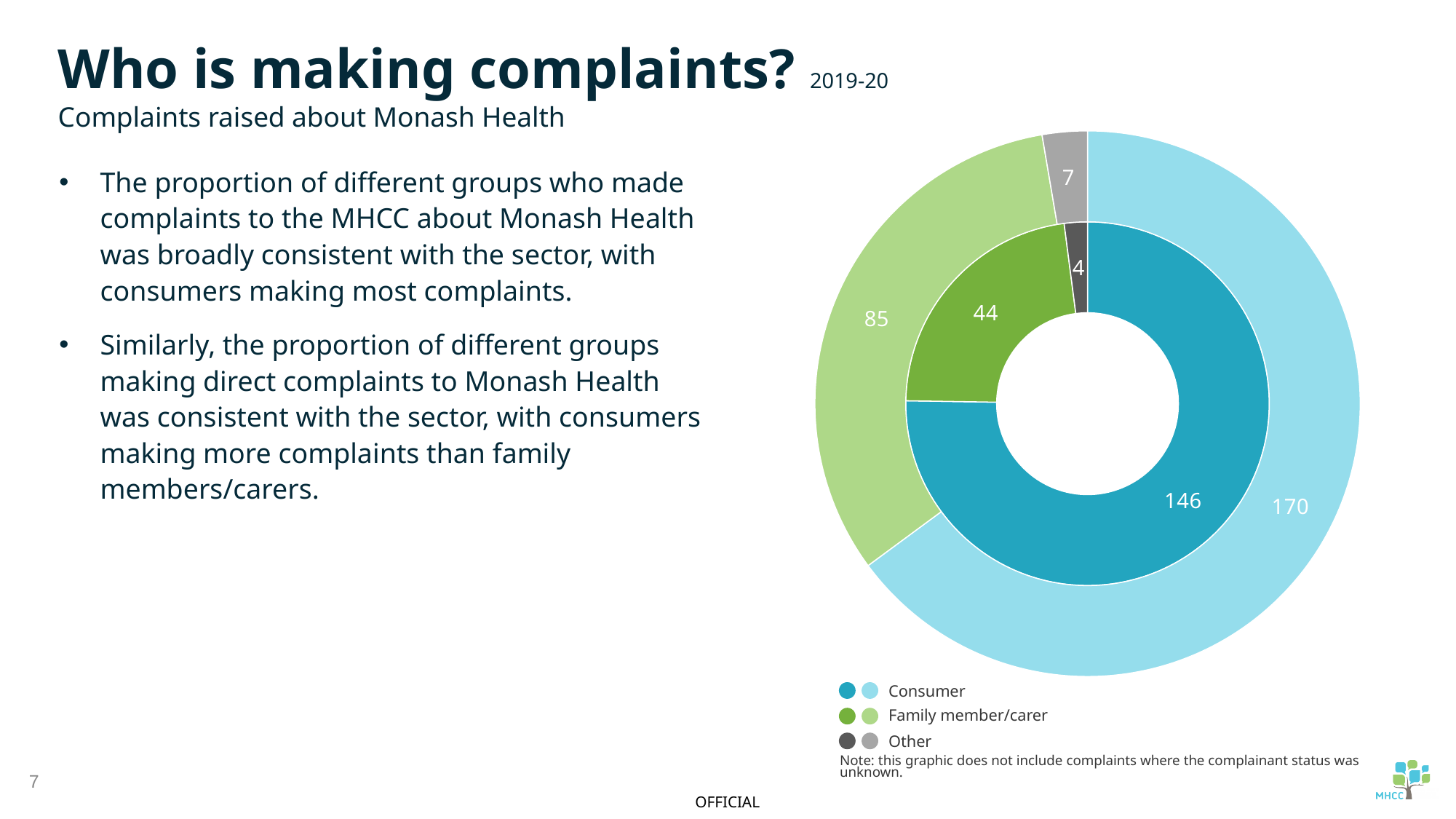
What kind of chart is shown on the slide? doughnut chart How many categories does the legend of the doughnut chart list? 3 What is the value for Consumer in the inner ring of the doughnut chart? 146 What is the difference between the Consumer and Family member/carer values in the outer ring? 85 Which category has the largest value in the outer ring of the doughnut chart? Consumer What is the total of the values in the inner ring of the doughnut chart? 194 What is the value for Other in the inner ring of the doughnut chart? 4 Which category has the smallest value in the inner ring of the doughnut chart? Other What is the value for Consumer in the outer ring of the doughnut chart? 170 What is the value for Family member/carer in the outer ring of the doughnut chart? 85 Which colour represents Family member/carer in the doughnut chart? green What is the value for Family member/carer in the inner ring of the doughnut chart? 44